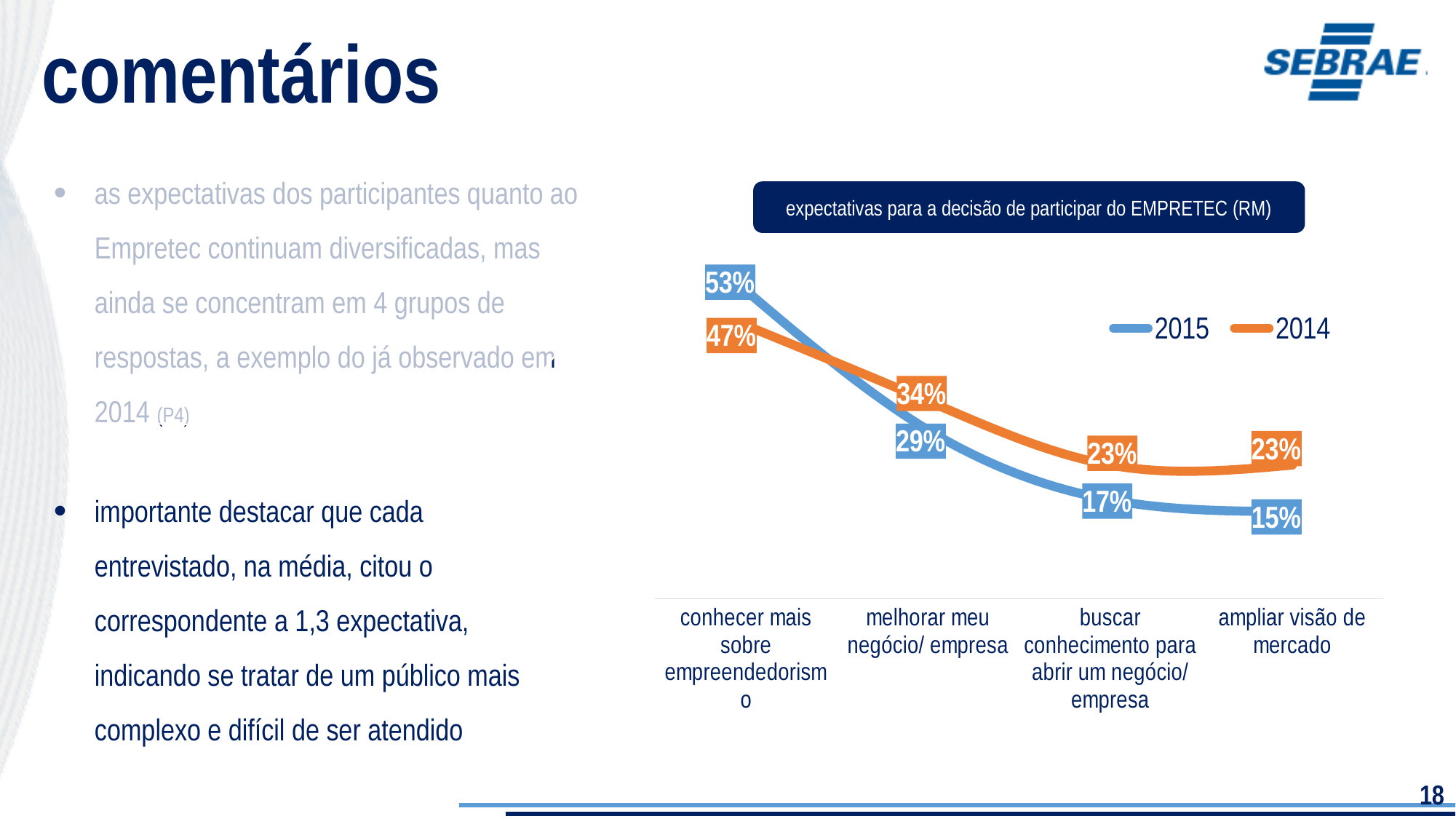
What kind of chart is shown on the slide? line chart Which is larger for 'melhorar meu negócio/ empresa': the 2015 value or the 2014 value? 2014 How many categories are shown on the x axis? 4 Which category has the highest 2015 value? conhecer mais sobre empreendedorismo What is the difference between the 2015 and 2014 values for 'conhecer mais sobre empreendedorismo'? 6% What is the 2014 value for 'melhorar meu negócio/ empresa'? 34% Which category has the lowest 2015 value? ampliar visão de mercado What is the 2014 value for 'buscar conhecimento para abrir um negócio/ empresa'? 23% What is the 2015 value for 'conhecer mais sobre empreendedorismo'? 53% How many series does the legend list? 2 Do the 2015 values rise or fall from left to right along the x axis? fall What is the 2015 value for 'ampliar visão de mercado'? 15%